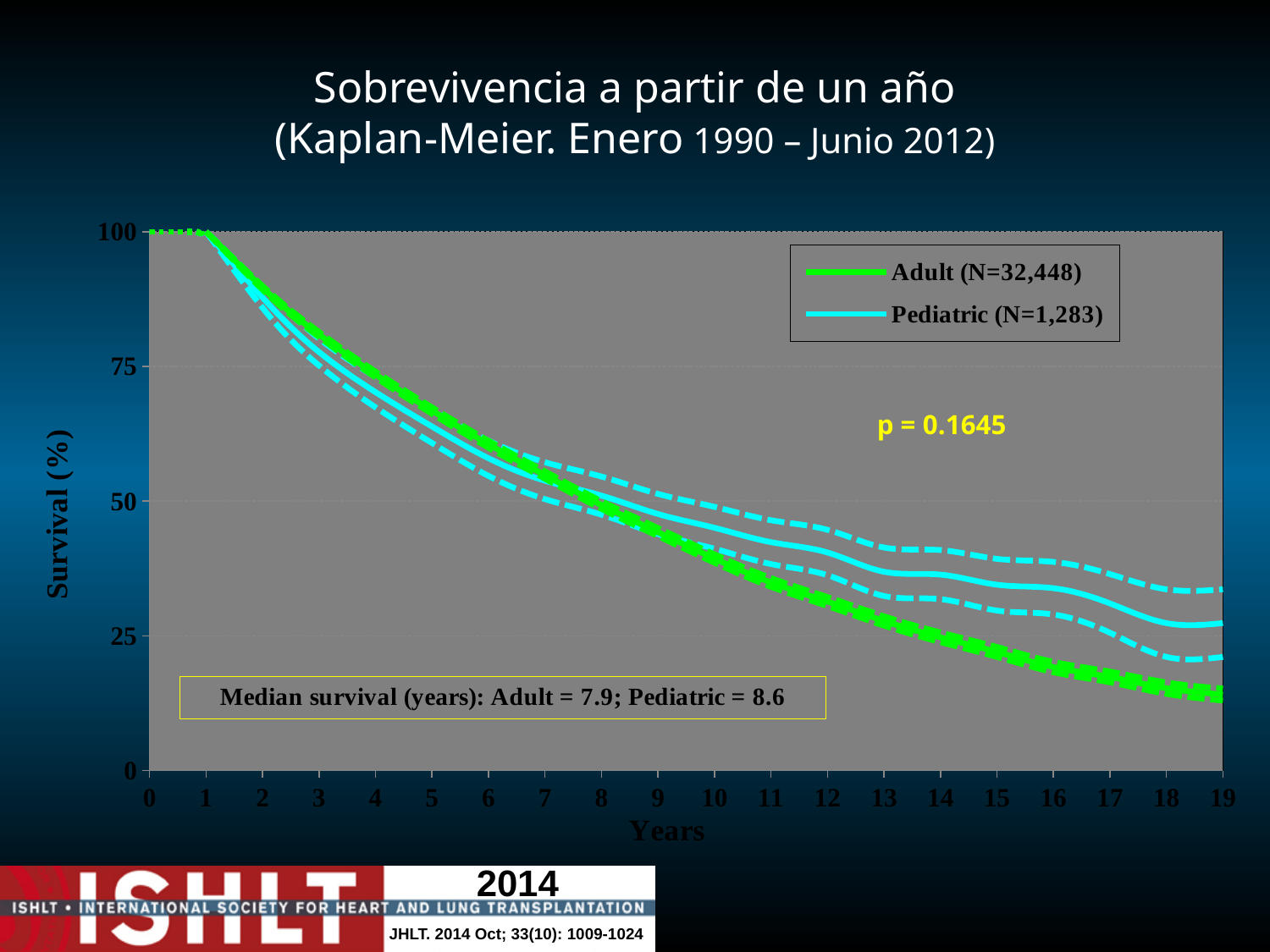
Is the Pediatric survival value at year 10 greater or less than 25? greater What is the median survival in years for the Adult group? 7.9 What is the median survival in years for the Pediatric group? 8.6 Do the survival curves rise or fall as years increase along the x axis? fall What are the two series named in the legend? Adult (N=32,448) and Pediatric (N=1,283) Is the Adult survival value at year 19 greater or less than 25? less What p-value is shown on the chart? p = 0.1645 What is the N for the Adult series according to the legend? 32,448 How many series does the legend list? 2 At year 15, which series has the higher survival, Adult or Pediatric? Pediatric What kind of chart is shown on the slide? line chart What is the N for the Pediatric series according to the legend? 1,283